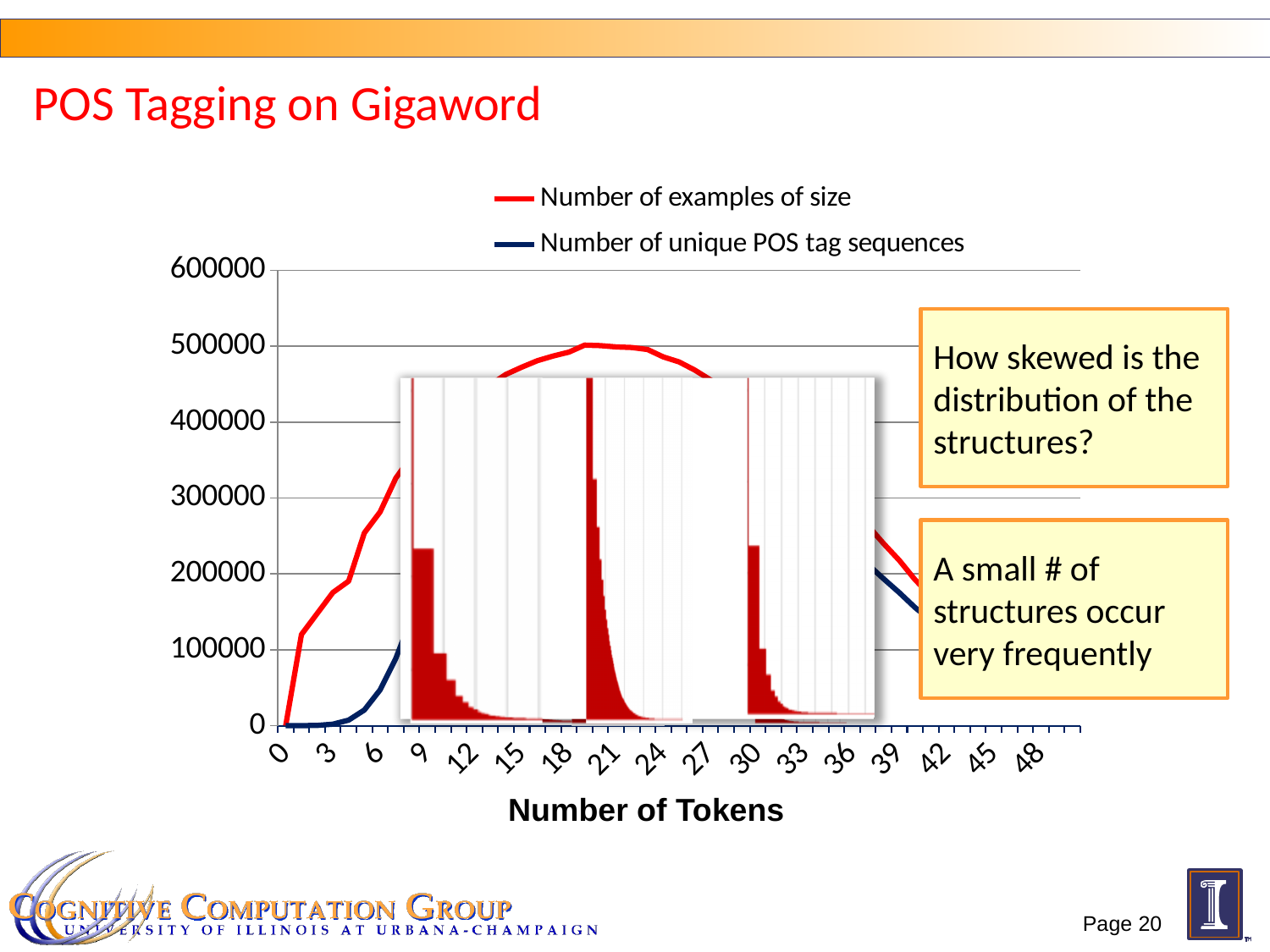
Is the value of 'Number of examples of size' at 3 tokens greater or less than 100000? greater Is the value of 'Number of unique POS tag sequences' at 6 tokens greater or less than 100000? less Does 'Number of examples of size' rise or fall between 0 and 6 tokens? rise At 6 tokens, which series has the larger value: 'Number of examples of size' or 'Number of unique POS tag sequences'? Number of examples of size Which series is drawn in red in the chart? Number of examples of size Is the value of 'Number of examples of size' at 6 tokens greater or less than 200000? greater What is the title of the x axis of the chart? Number of Tokens What is the highest value labelled on the y axis of the chart? 600000 Which series reaches the higher maximum value in the chart? Number of examples of size What kind of chart is shown on the slide? line chart How many series does the chart's legend list? 2